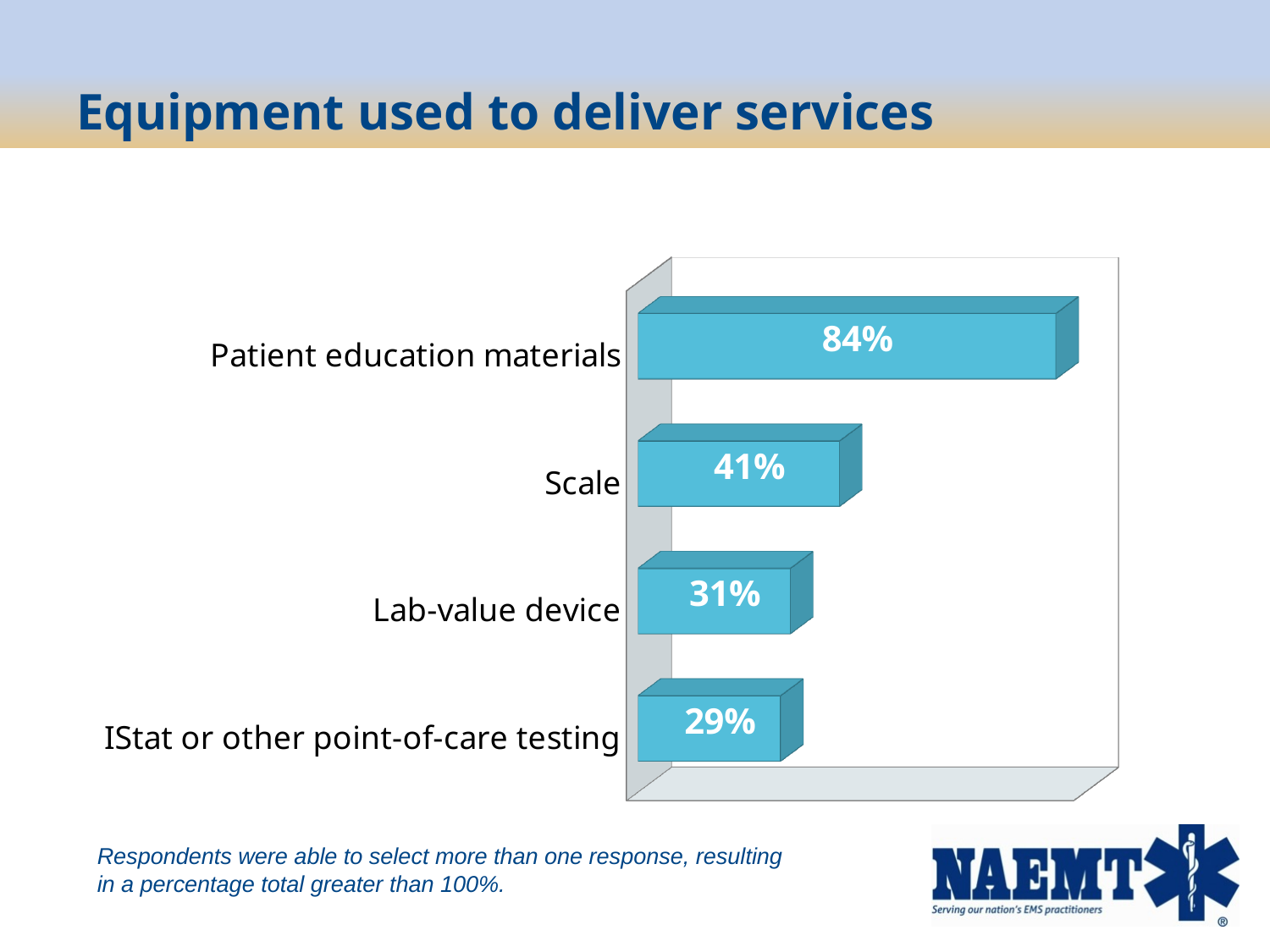
What is the value for Scale? 41% What kind of chart is shown on the slide? Bar chart What is the value for Lab-value device? 31% Which equipment category has the highest value? Patient education materials What is the value for IStat or other point-of-care testing? 29% Which equipment category has the lowest value? IStat or other point-of-care testing What is the title of the slide containing the chart? Equipment used to deliver services What percentage of respondents use patient education materials? 84% Which has a larger value, Scale or Lab-value device? Scale What is the difference between the values for Lab-value device and IStat or other point-of-care testing? 2% How many equipment categories are shown in the chart? 4 What is the difference between the values for Patient education materials and Scale? 43%